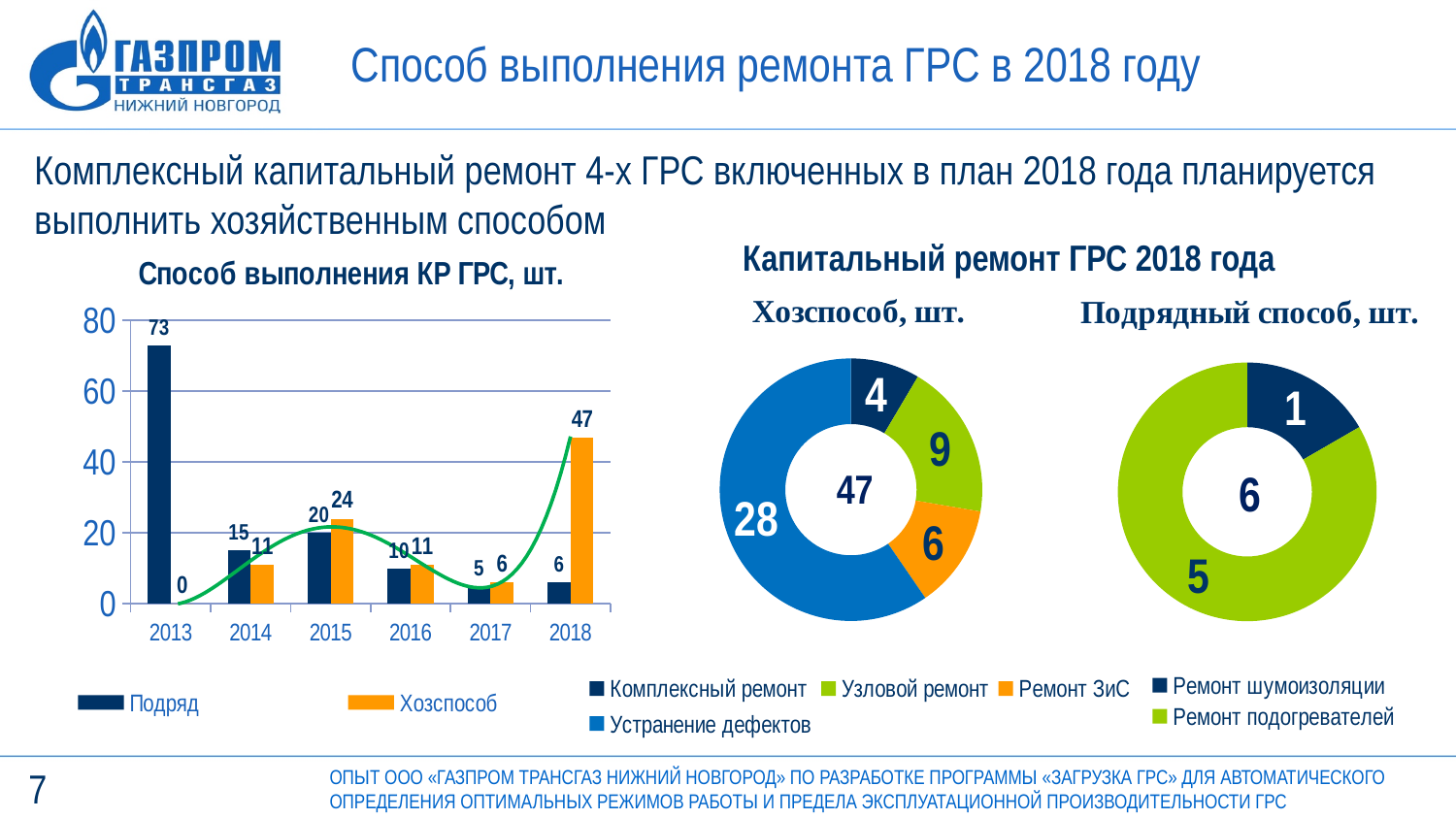
In the chart 'Способ выполнения КР ГРС, шт.', what is the value for Подряд in 2013? 73 In the chart 'Способ выполнения КР ГРС, шт.', which is larger in 2014: Подряд or Хозспособ? Подряд In the donut chart 'Подрядный способ, шт.', what is the value for Ремонт подогревателей? 5 In the chart 'Способ выполнения КР ГРС, шт.', what is the value for Хозспособ in 2018? 47 In the chart 'Способ выполнения КР ГРС, шт.', what is the value for Хозспособ in 2015? 24 What type of chart is 'Способ выполнения КР ГРС, шт.'? Bar chart In the chart 'Способ выполнения КР ГРС, шт.', in which year is the Подряд value highest? 2013 In the chart 'Способ выполнения КР ГРС, шт.', in which year is the Хозспособ value lowest? 2013 In the chart 'Способ выполнения КР ГРС, шт.', how many series does the legend list? 2 In the chart 'Способ выполнения КР ГРС, шт.', what is the difference between Хозспособ and Подряд in 2018? 41 In the donut chart 'Хозспособ, шт.', what is the value for Устранение дефектов? 28 In the chart 'Способ выполнения КР ГРС, шт.', how many years are shown on the x axis? 6